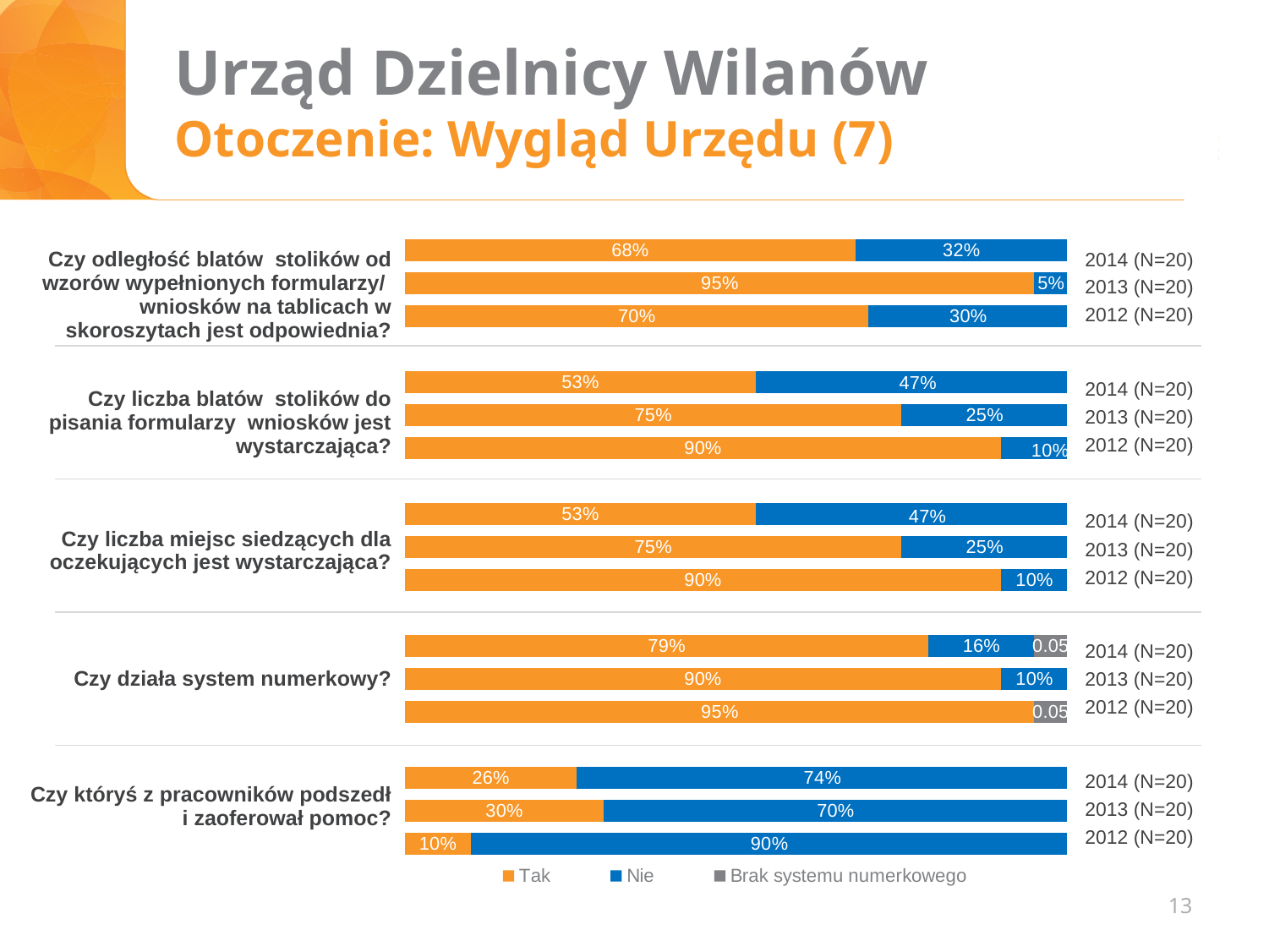
What percentage answered "Nie" in 2014 to "Czy liczba miejsc siedzących dla oczekujących jest wystarczająca?"? 47% What percentage answered "Tak" in 2014 to "Czy odległość blatów stolików od wzorów wypełnionych formularzy/wniosków na tablicach w skoroszytach jest odpowiednia?"? 68% What kind of chart is shown on the slide? Stacked bar chart What percentage answered "Nie" in 2012 to "Czy któryś z pracowników podszedł i zaoferował pomoc?"? 90% How many series does the legend list? 3 What percentage answered "Tak" in 2014 to "Czy działa system numerkowy?"? 79% For "Czy działa system numerkowy?", which year had the lowest "Tak" share? 2014 What percentage answered "Nie" in 2013 to "Czy odległość blatów stolików od wzorów wypełnionych formularzy/wniosków na tablicach w skoroszytach jest odpowiednia?"? 5% For "Czy któryś z pracowników podszedł i zaoferował pomoc?", which year had the highest "Tak" share? 2013 What percentage answered "Tak" in 2012 to "Czy liczba blatów stolików do pisania formularzy wniosków jest wystarczająca?"? 90% What is the difference between the "Tak" share in 2013 and in 2014 for "Czy odległość blatów stolików od wzorów wypełnionych formularzy/wniosków na tablicach w skoroszytach jest odpowiednia?"? 27 percentage points For "Czy liczba blatów stolików do pisania formularzy wniosków jest wystarczająca?", was the "Tak" share larger in 2013 or in 2014? 2013